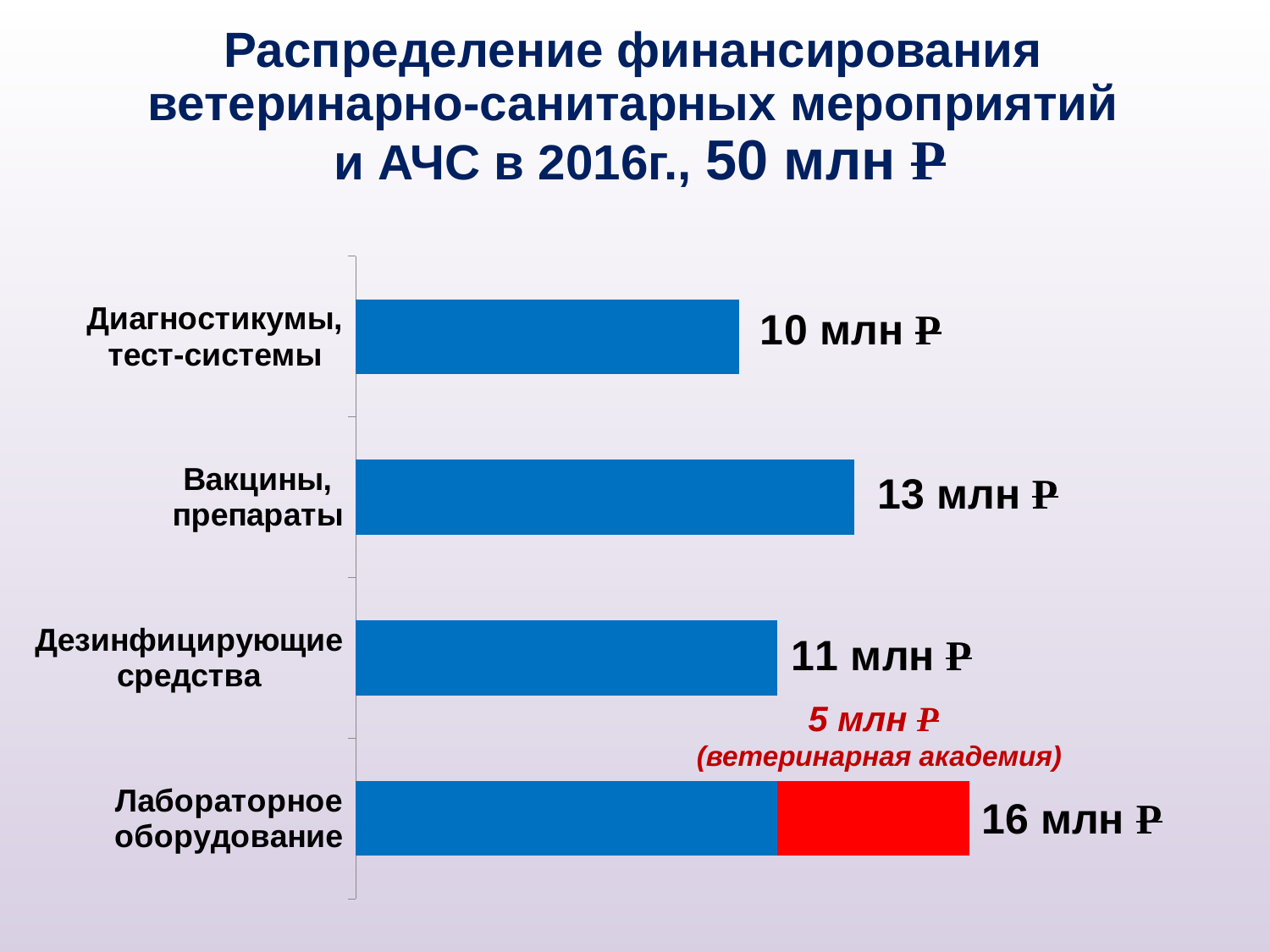
Which category has the highest value? Лабораторное оборудование What kind of chart is shown on the slide? Bar chart Which is larger: Вакцины, препараты or Дезинфицирующие средства? Вакцины, препараты How much of the Лабораторное оборудование bar is attributed to the ветеринарная академия (red segment)? 5 млн ₽ Which category has the lowest value? Диагностикумы, тест-системы What is the value for Дезинфицирующие средства? 11 млн ₽ What is the value for Вакцины, препараты? 13 млн ₽ What total amount of funding is stated in the chart title? 50 млн ₽ What is the value for Диагностикумы, тест-системы? 10 млн ₽ How many categories are shown in the chart? 4 What is the total value for Лабораторное оборудование? 16 млн ₽ What is the difference between Лабораторное оборудование and Диагностикумы, тест-системы? 6 млн ₽